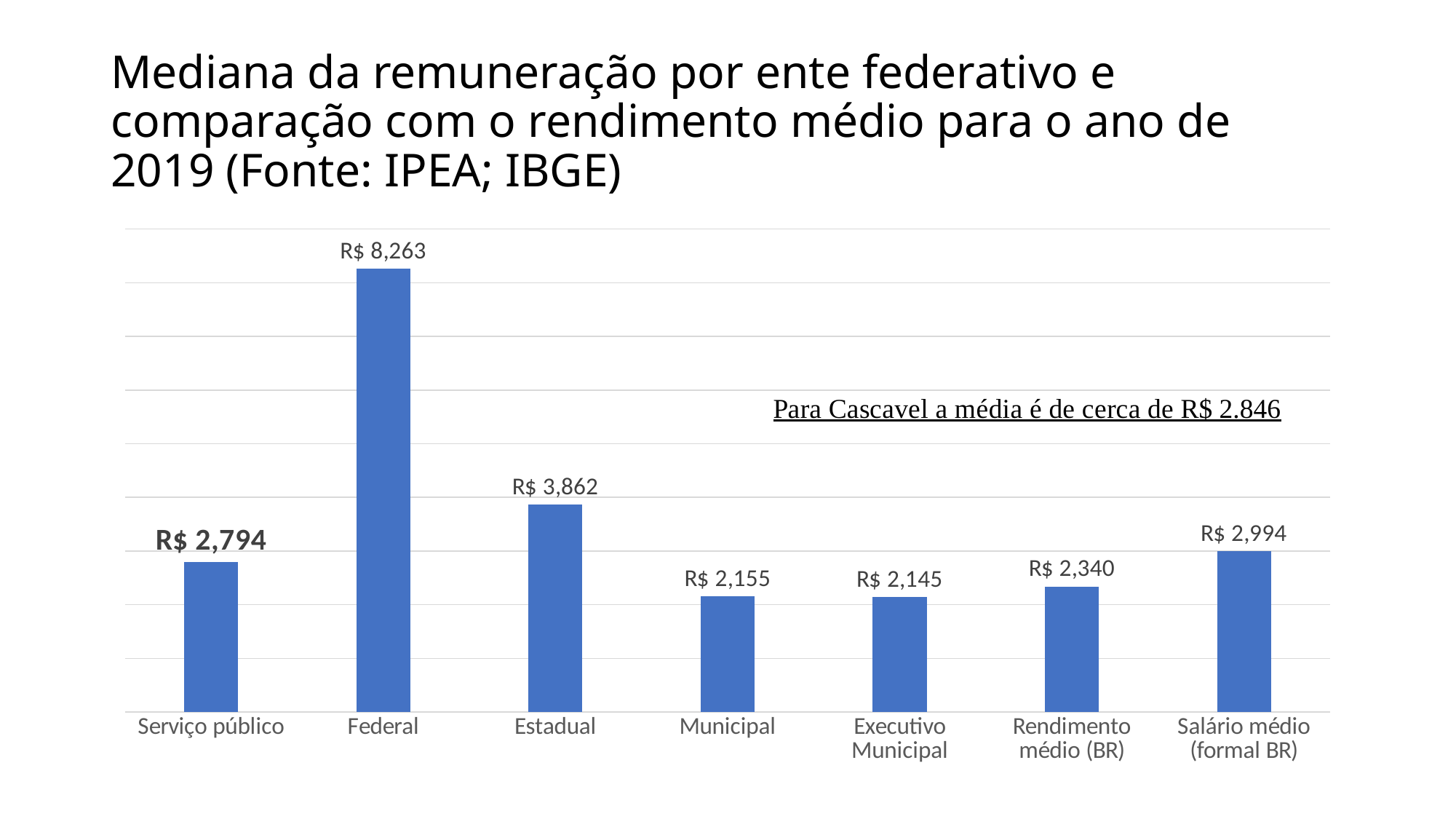
Which is larger, the value for Estadual or the value for Salário médio (formal BR)? Estadual What is the value for Estadual? R$ 3,862 What is the value for Serviço público? R$ 2,794 Which category has the highest value? Federal Which is larger, the value for Serviço público or the value for Rendimento médio (BR)? Serviço público What is the value for Salário médio (formal BR)? R$ 2,994 What is the value for Federal? R$ 8,263 What is the difference between Salário médio (formal BR) and Rendimento médio (BR)? R$ 654 What is the value for Rendimento médio (BR)? R$ 2,340 What kind of chart is shown on the slide? Bar chart How many categories are shown on the x axis? 7 What is the difference between the Federal and Estadual values? R$ 4,401